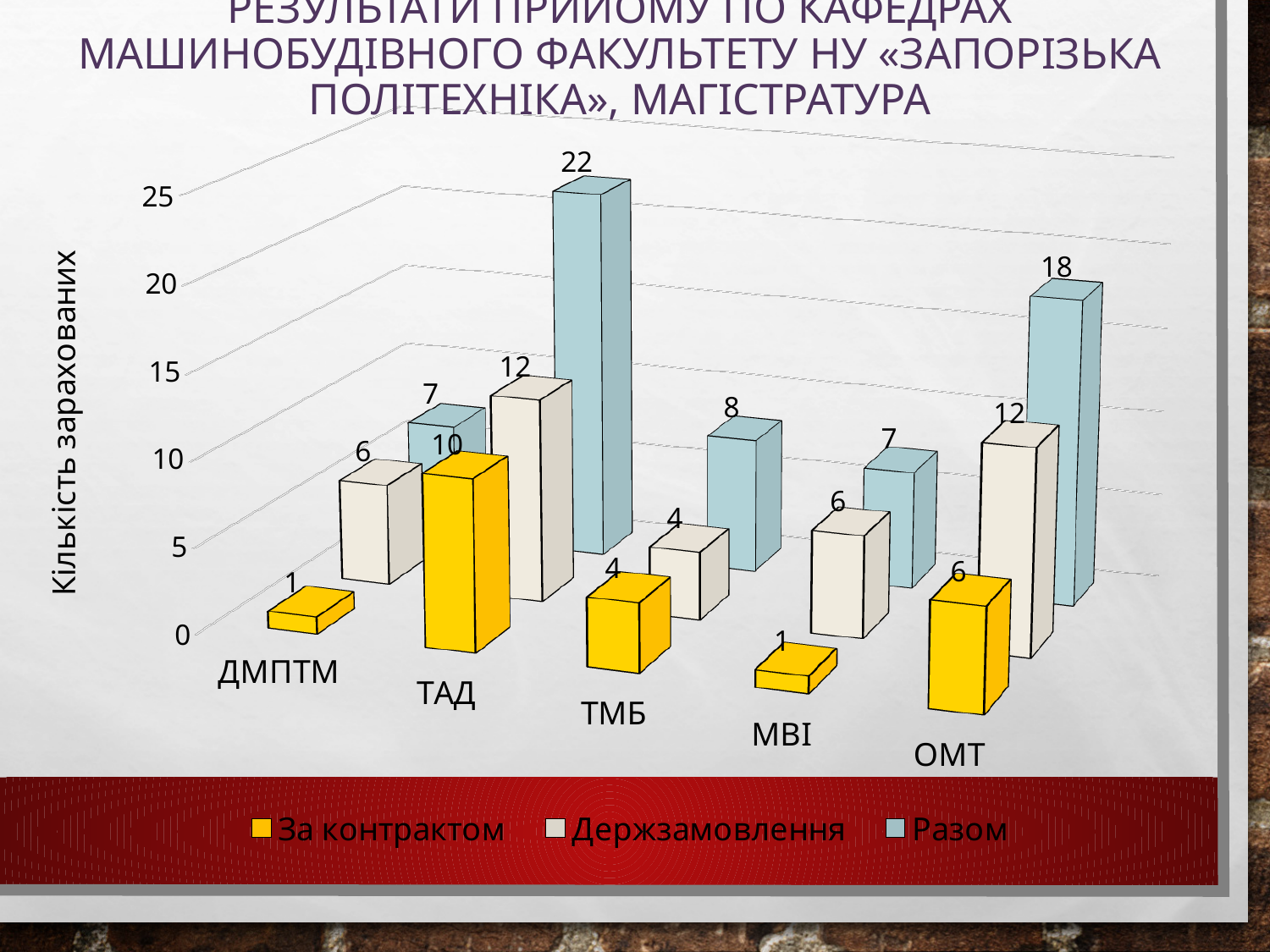
What is the difference between the Разом values for ТАД and ОМТ? 4 Which category has the highest Разом value? ТАД What kind of chart is shown on the slide? Bar chart What is the value of Разом for ТАД? 22 What is the label of the vertical axis? Кількість зарахованих Which category has the lowest Разом value? ДМПТМ and МВІ (both 7) What is the value of За контрактом for ОМТ? 6 How many categories are shown on the x axis? 5 Which is larger: За контрактом for ТАД or За контрактом for ОМТ? ТАД How many series does the legend list? 3 What is the value of Держзамовлення for МВІ? 6 Which series is shown in yellow in the legend? За контрактом